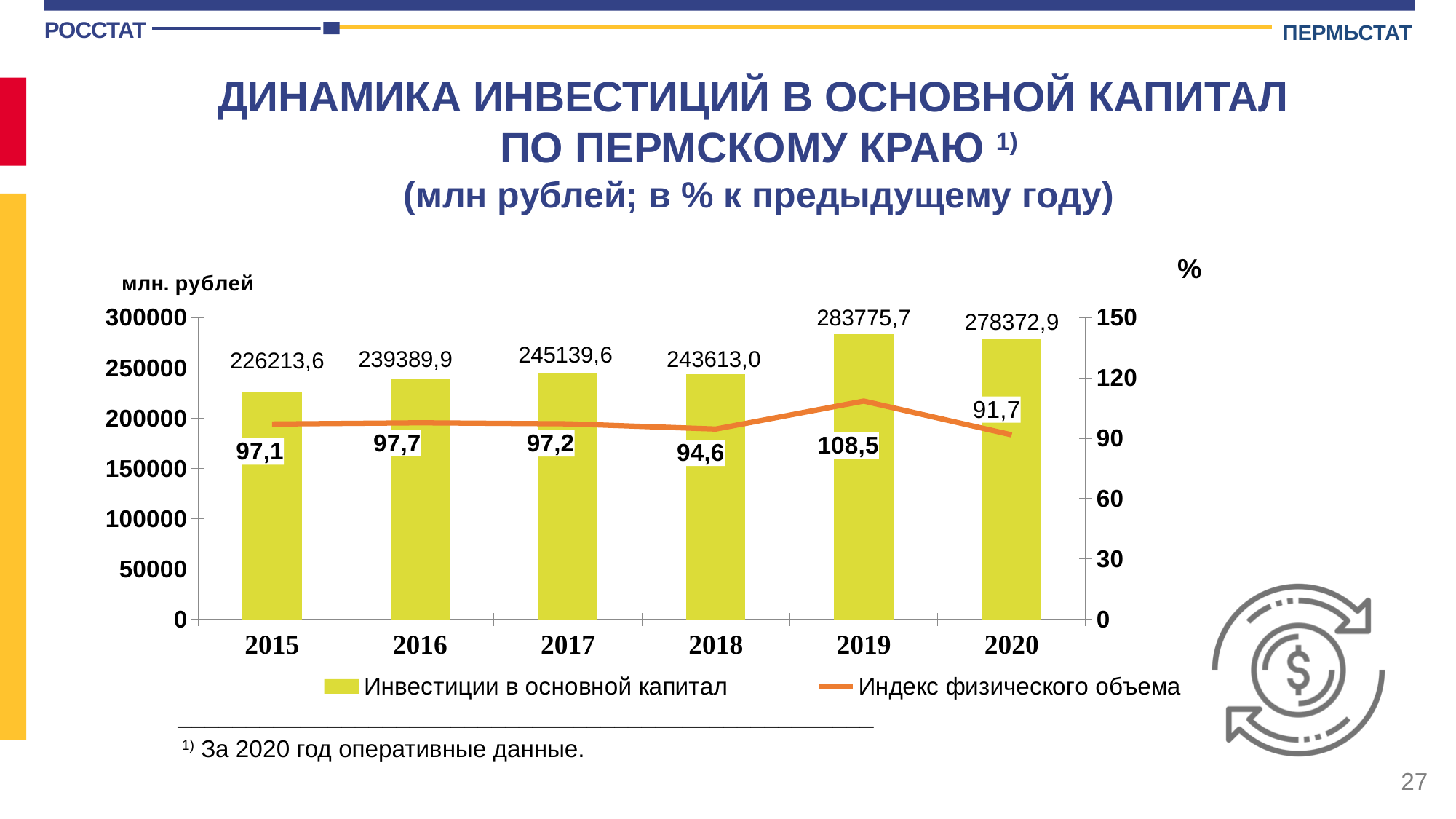
How many years are shown on the x axis of the chart? 6 How many series does the legend list? 2 What is the physical volume index (Индекс физического объема) for 2018? 94,6 What kind of chart is shown on the slide? Combined bar and line chart Which year has the lowest value of investments in fixed capital? 2015 What is the value of investments in fixed capital for 2020? 278372,9 By how much did the physical volume index fall from 2019 to 2020? 16,8 Which year has the lowest physical volume index? 2020 What is the difference between the investments in fixed capital in 2019 and 2020? 5402,8 What is the value of investments in fixed capital (Инвестиции в основной капитал) for 2017? 245139,6 Which year has the highest value of investments in fixed capital? 2019 Which is larger: investments in fixed capital in 2016 or in 2018? 2018